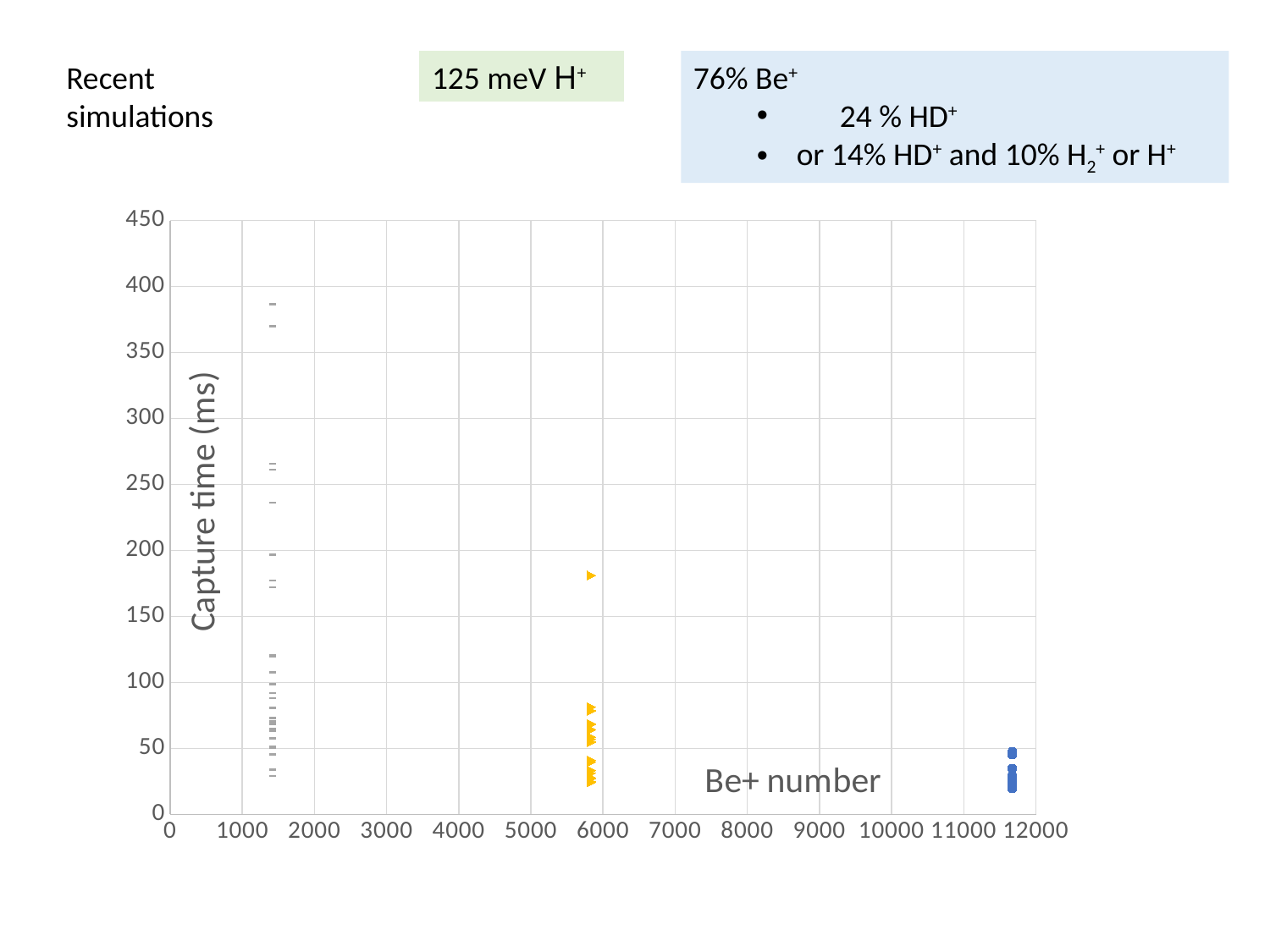
As the Be+ number increases along the x axis, does the maximum capture time rise or fall? fall Is the highest capture time plotted for the gray points near 1400 Be+ greater or less than 350 ms? greater Is the highest capture time plotted for the yellow triangles near 5800 Be+ greater or less than 150 ms? greater What is the label of the vertical axis of the chart? Capture time (ms) Which group of points has the lowest maximum capture time: the gray points, the yellow triangles, or the blue points? the blue points Which group of points reaches the highest capture time: the gray points, the yellow triangles, or the blue points? the gray points Which reaches a higher capture time: the yellow triangles near 5800 Be+ or the blue points near 11700 Be+? the yellow triangles What is the maximum value shown on the vertical axis of the chart? 450 What is the label of the horizontal axis of the chart? Be+ number Is the highest capture time plotted for the blue points near 11700 Be+ greater or less than 100 ms? less How many distinct groups (clusters) of data points are plotted on the chart? 3 What kind of chart is shown on the slide? scatter chart